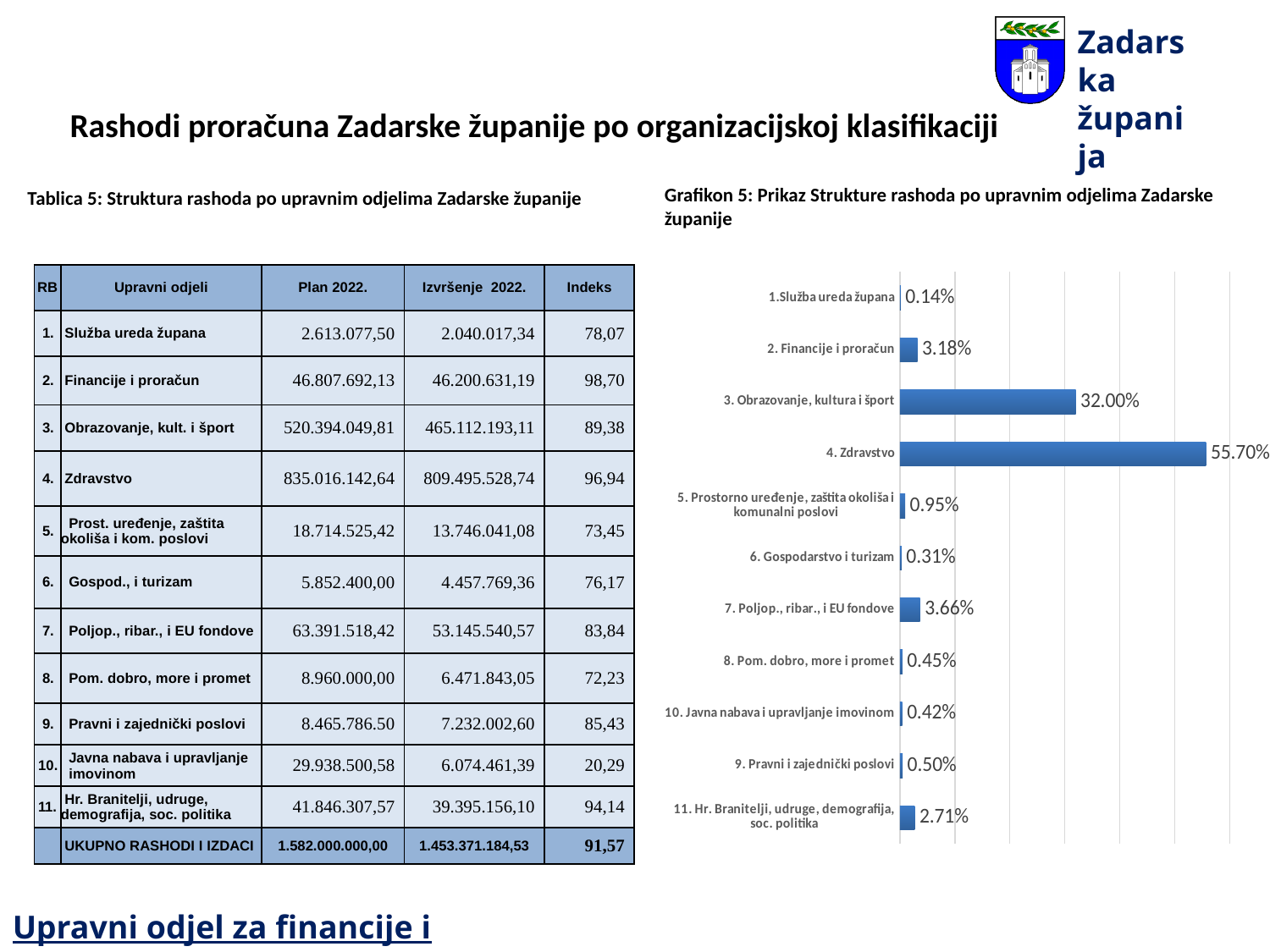
Which is larger in the chart: 2. Financije i proračun or 7. Poljop., ribar., i EU fondove? 7. Poljop., ribar., i EU fondove What is the value for 3. Obrazovanje, kultura i šport in the chart? 32.00% What is the value for 7. Poljop., ribar., i EU fondove in the chart? 3.66% How many categories are shown in the chart? 11 What is the value for 1.Služba ureda župana in the chart? 0.14% What is the difference between the values for 4. Zdravstvo and 3. Obrazovanje, kultura i šport? 23.70% What is the value for 4. Zdravstvo in the chart? 55.70% What is the title of the chart on the slide? Grafikon 5: Prikaz Strukture rashoda po upravnim odjelima Zadarske županije Which category has the lowest value in the chart? 1.Služba ureda župana Which category has the highest value in the chart? 4. Zdravstvo What is the value for 11. Hr. Branitelji, udruge, demografija, soc. politika in the chart? 2.71% What kind of chart is shown in Grafikon 5? bar chart